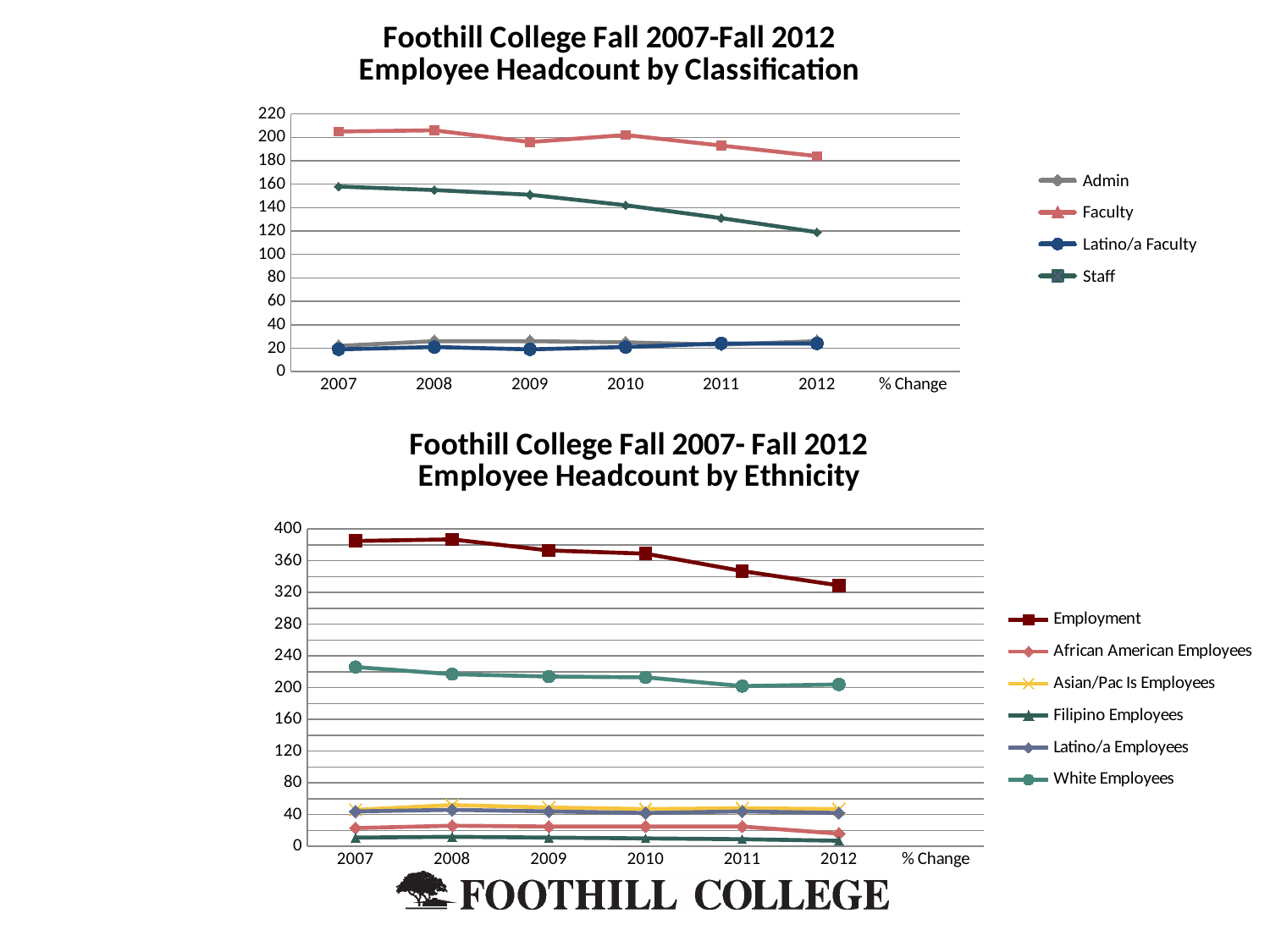
What kind of chart is the top chart, 'Employee Headcount by Classification'? line chart In the bottom chart, 'Employee Headcount by Ethnicity', how many series does the legend list? 6 In the top chart, 'Employee Headcount by Classification', does the Staff headcount rise or fall from 2007 to 2012? fall In the bottom chart, 'Employee Headcount by Ethnicity', does the Employment line rise or fall from 2007 to 2012? fall In the top chart, 'Employee Headcount by Classification', is the Staff value for 2007 greater or less than 140? greater In the bottom chart, 'Employee Headcount by Ethnicity', is the Employment value for 2012 greater or less than 360? less In the bottom chart, 'Employee Headcount by Ethnicity', is the White Employees value for 2011 greater or less than 240? less In the top chart, 'Employee Headcount by Classification', how many series does the legend list? 4 In the bottom chart, 'Employee Headcount by Ethnicity', how many years have data points plotted? 6 In the top chart, 'Employee Headcount by Classification', which series has the highest value in 2012? Faculty In the bottom chart, 'Employee Headcount by Ethnicity', which series has the lowest value in 2012? Filipino Employees